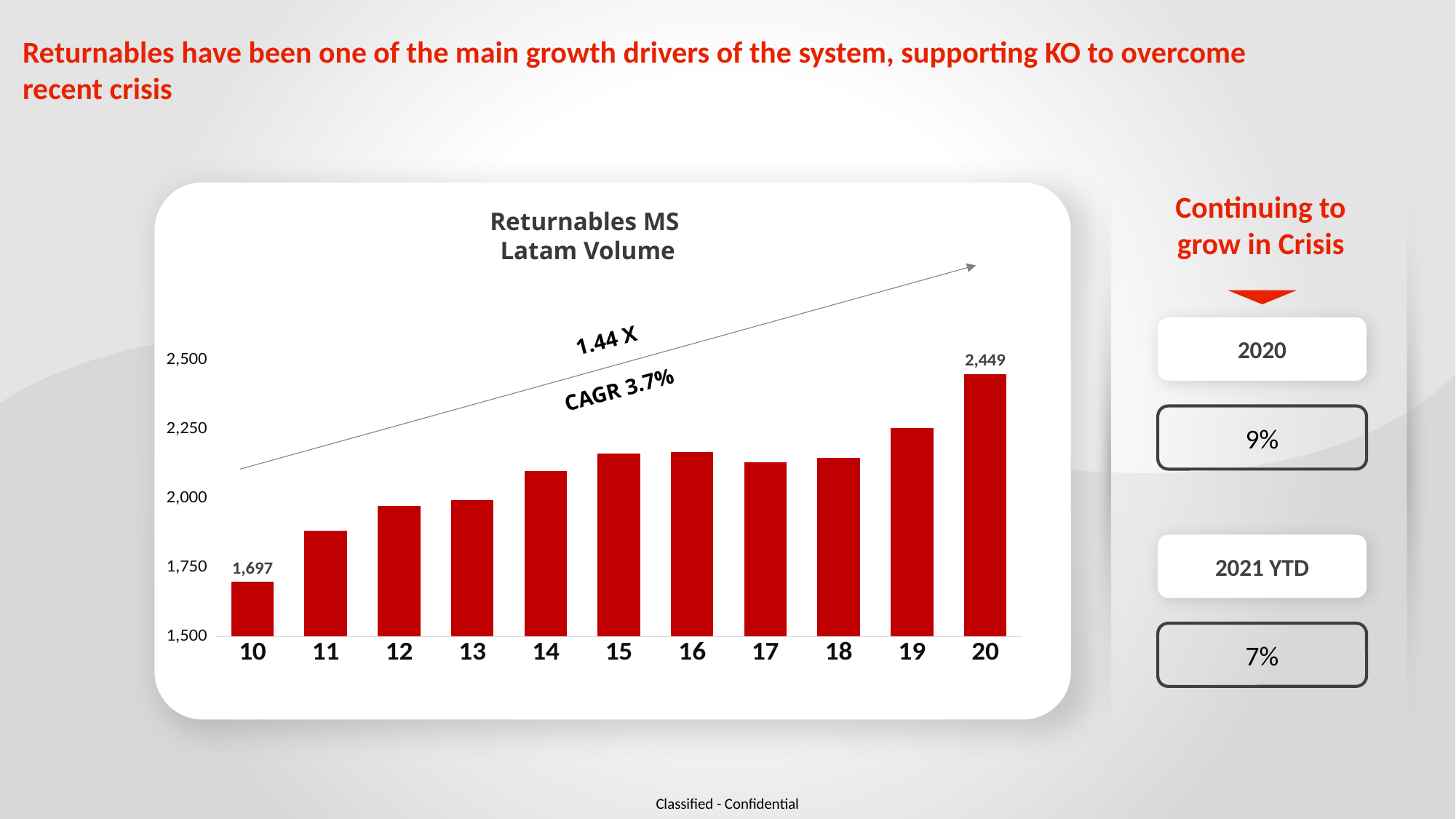
How many years are shown on the x axis of the Returnables MS Latam Volume chart? 11 Which is larger in the Returnables MS Latam Volume chart, the value for 14 or the value for 12? 14 What kind of chart is the Returnables MS Latam Volume chart? bar chart What is the difference between the values for 20 and 10 in the Returnables MS Latam Volume chart? 752 What is the value for 10 in the Returnables MS Latam Volume chart? 1,697 What CAGR is annotated on the Returnables MS Latam Volume chart? 3.7% What is the value for 20 in the Returnables MS Latam Volume chart? 2,449 Which year has the highest value in the Returnables MS Latam Volume chart? 20 Is the value for 19 greater or less than 2,000 in the Returnables MS Latam Volume chart? greater Do the values in the Returnables MS Latam Volume chart generally rise or fall from 10 to 20? rise Is the value for 11 greater or less than 2,000 in the Returnables MS Latam Volume chart? less Which year has the lowest value in the Returnables MS Latam Volume chart? 10